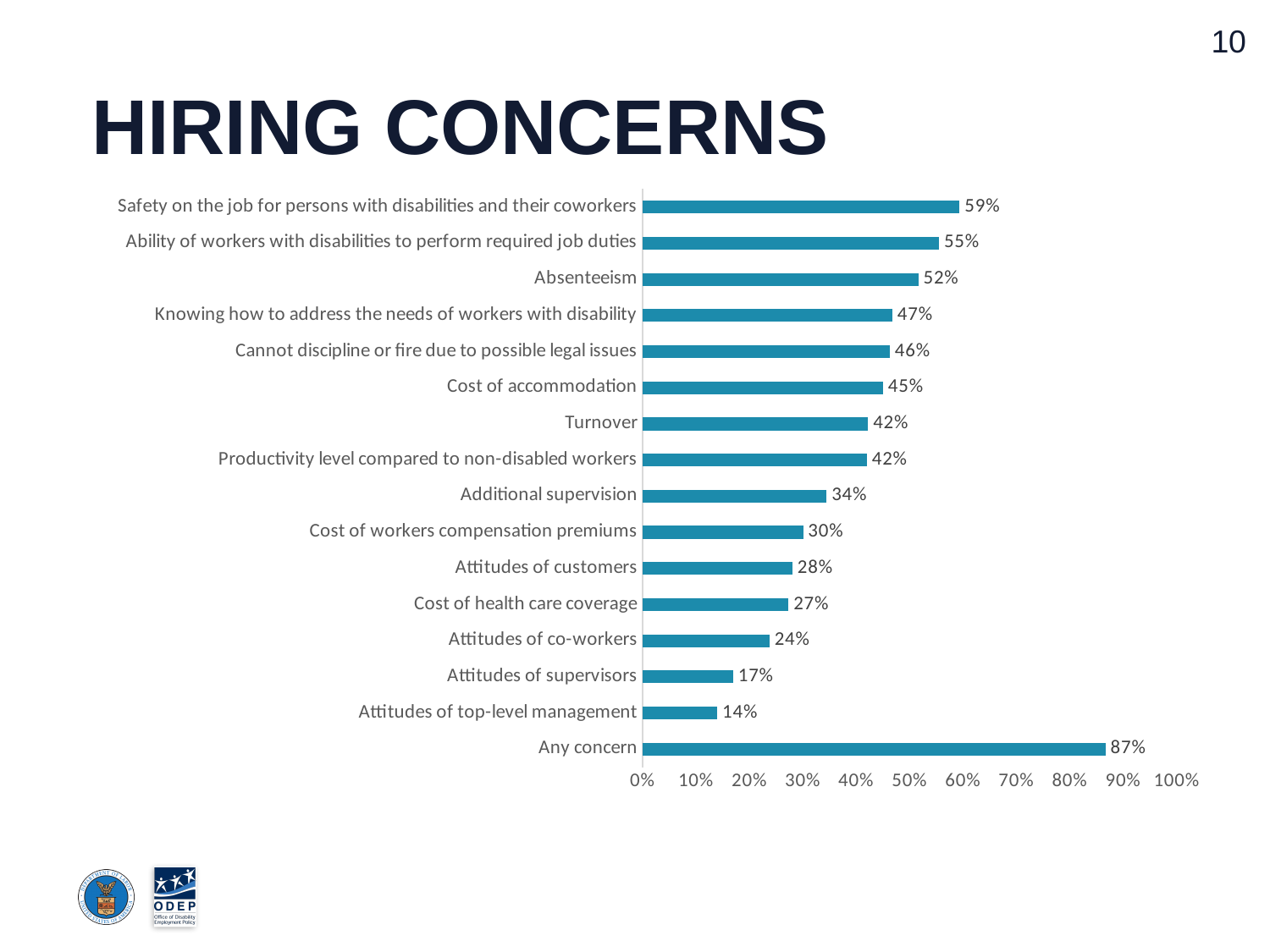
What is the difference between Additional supervision and Attitudes of supervisors? 17% Which category has the lowest value? Attitudes of top-level management What kind of chart is shown on the slide? Bar chart What is the title of the slide? HIRING CONCERNS What is the difference between the values for Any concern and Safety on the job for persons with disabilities and their coworkers? 28% How many categories are shown in the chart? 16 Which category has the highest value? Any concern What percentage is shown for Absenteeism? 52% Is the value for Ability of workers with disabilities to perform required job duties greater or less than 50%? greater Which is larger, the value for Turnover or the value for Cost of health care coverage? Turnover What is the value for Cost of accommodation? 45% What percentage is shown for Attitudes of top-level management? 14%